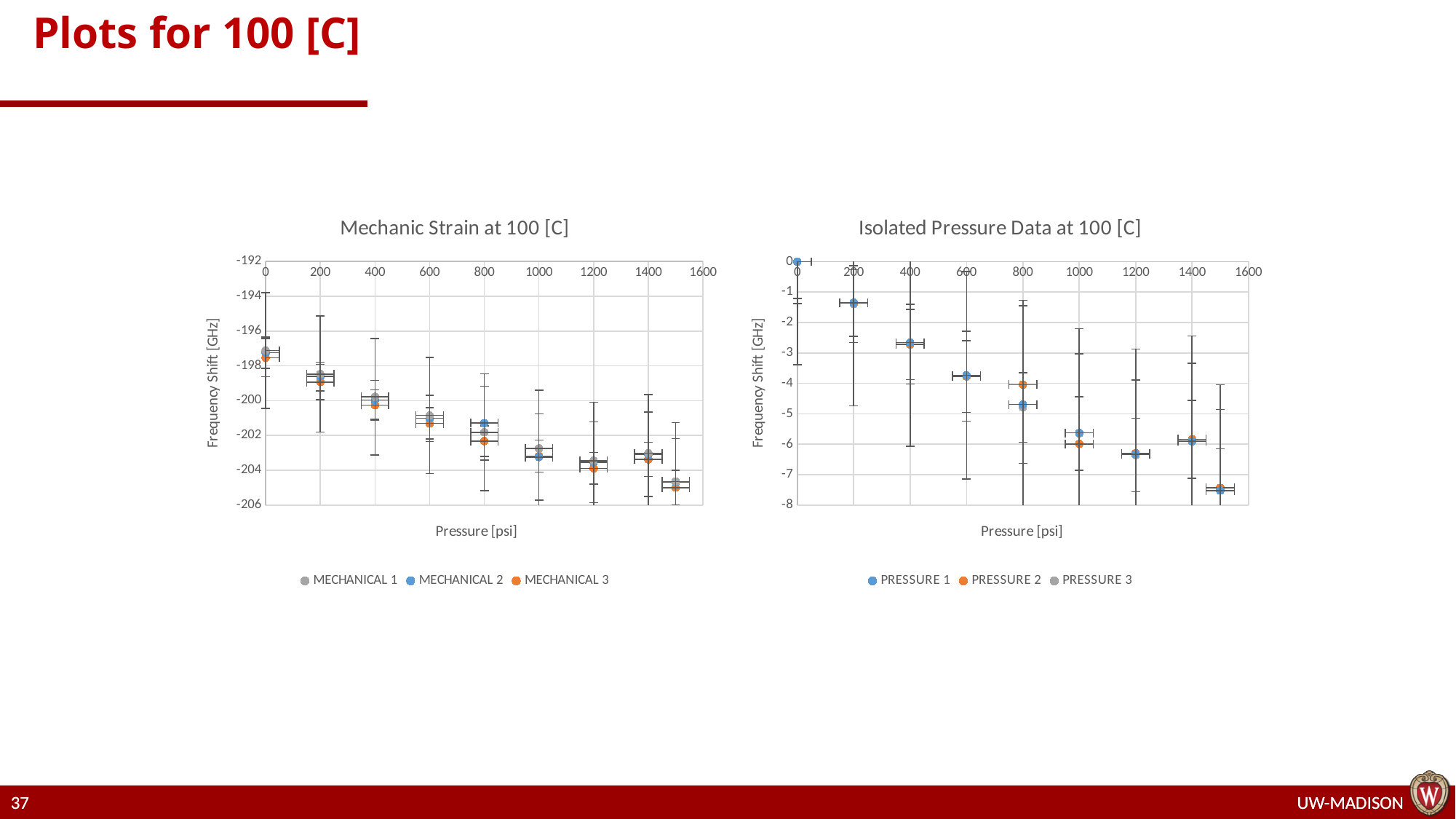
In the 'Isolated Pressure Data at 100 [C]' chart, is the frequency shift at 1500 psi greater or less than -7? less In the 'Mechanic Strain at 100 [C]' chart, do the frequency shift values rise or fall as pressure increases? fall In the 'Isolated Pressure Data at 100 [C]' chart, what is the frequency shift at 0 psi? 0 How many series does the legend of the 'Mechanic Strain at 100 [C]' chart list? 3 In the 'Isolated Pressure Data at 100 [C]' chart, at which pressure is the frequency shift lowest? 1500 psi In the 'Mechanic Strain at 100 [C]' chart, is the frequency shift at 1000 psi greater or less than -202? less In the 'Isolated Pressure Data at 100 [C]' chart, which has the larger frequency shift: the point at 200 psi or the point at 1400 psi? 200 psi How many series does the legend of the 'Isolated Pressure Data at 100 [C]' chart list? 3 In the 'Mechanic Strain at 100 [C]' chart, is the frequency shift at 1500 psi greater or less than -204? less What is the y-axis label of the 'Isolated Pressure Data at 100 [C]' chart? Frequency Shift [GHz] What kind of chart is the 'Mechanic Strain at 100 [C]' chart? scatter chart